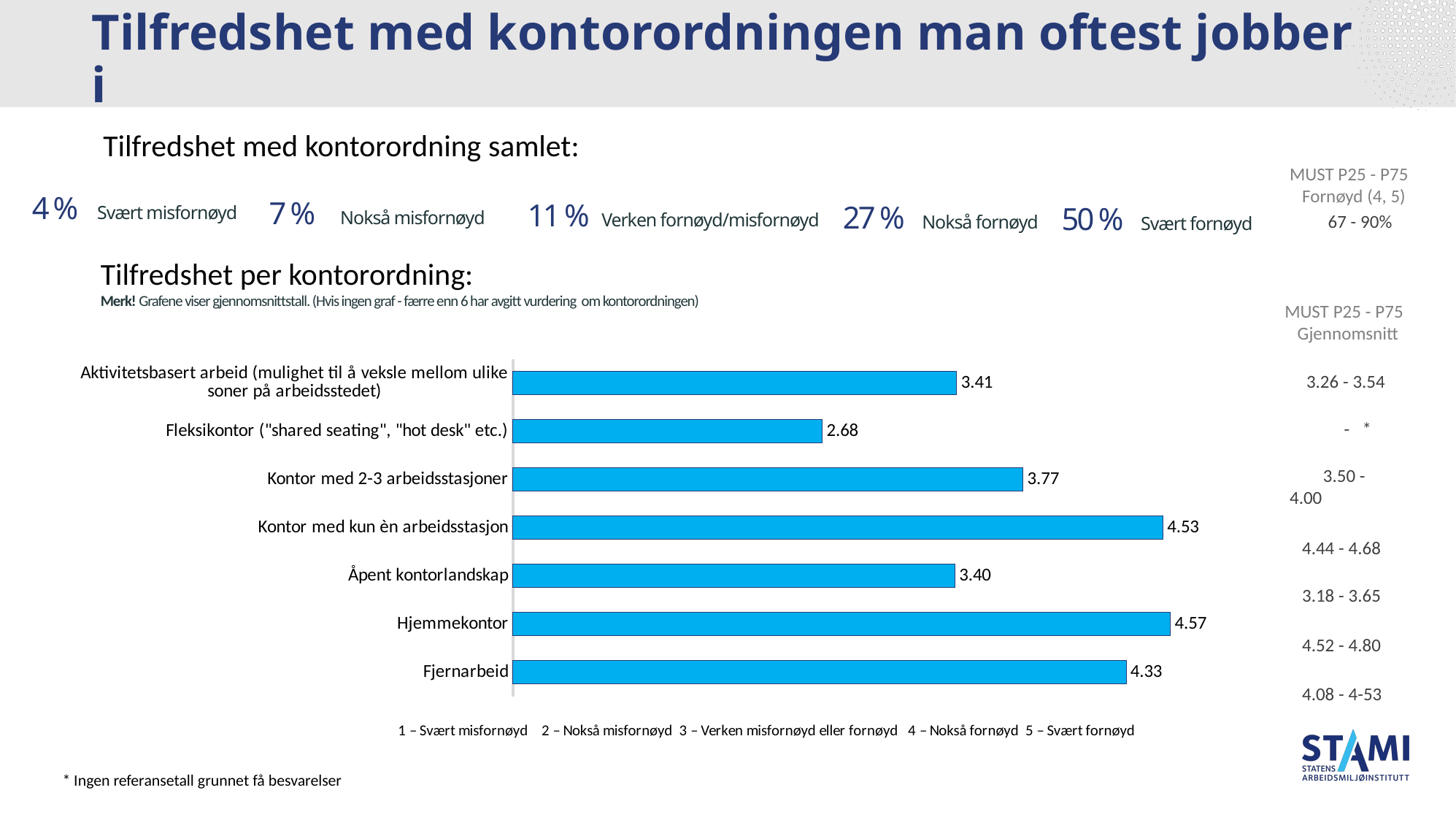
What is the value for Hjemmekontor in the bar chart? 4.57 What is the difference between the values for Hjemmekontor and Fjernarbeid? 0.24 What is the value for Åpent kontorlandskap in the bar chart? 3.40 Which category has the highest value in the bar chart? Hjemmekontor What is the value for Fleksikontor ("shared seating", "hot desk" etc.) in the bar chart? 2.68 Which has a larger value, Kontor med 2-3 arbeidsstasjoner or Aktivitetsbasert arbeid? Kontor med 2-3 arbeidsstasjoner How many categories are shown in the bar chart? 7 What kind of chart is shown on the slide? Bar chart What is the difference between the values for Kontor med kun èn arbeidsstasjon and Kontor med 2-3 arbeidsstasjoner? 0.76 Which category has the lowest value in the bar chart? Fleksikontor ("shared seating", "hot desk" etc.) What is the value for Fjernarbeid in the bar chart? 4.33 What colour are the bars in the chart? Blue